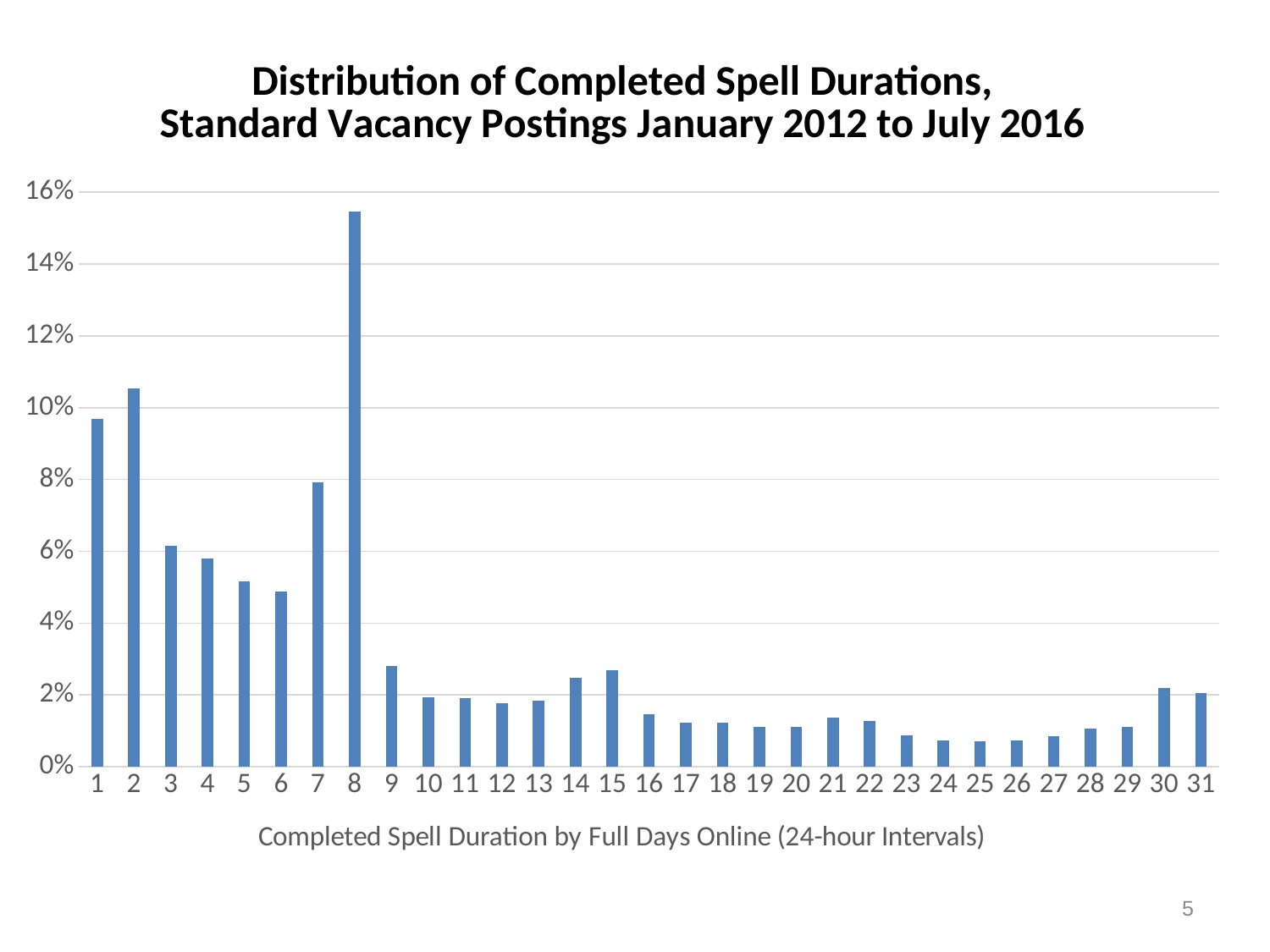
How many categories (days) are shown on the x axis? 31 Is the value for day 1 greater or less than 10%? less Which is larger, the value for day 2 or the value for day 1? day 2 Is the value for day 2 greater or less than 10%? greater Which is larger, the value for day 9 or the value for day 10? day 9 Which day has the highest share of completed spell durations? 8 What kind of chart is shown on the slide? bar chart Do the values rise or fall from day 3 to day 6? fall Is the value for day 16 greater or less than 2%? less What is the x-axis title of the chart? Completed Spell Duration by Full Days Online (24-hour Intervals)